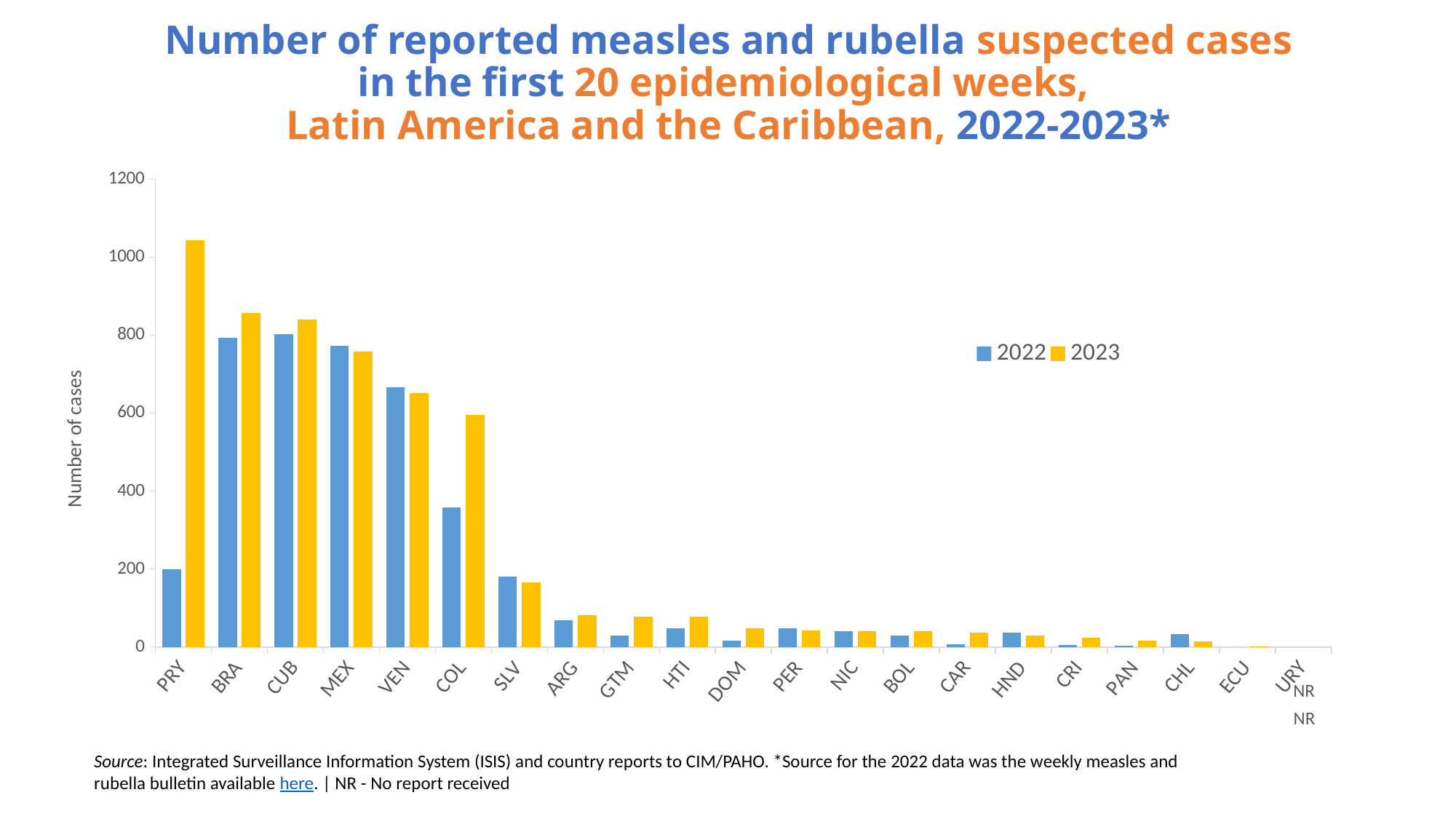
Is the 2023 value for BRA greater or less than 800? greater How many countries are shown on the x axis? 21 Which country has the highest number of suspected cases in 2023? PRY What is the label of the y axis? Number of cases For PRY, which year has the larger value, 2022 or 2023? 2023 How many series does the legend list? 2 Is the 2023 value for PRY greater or less than 1000? greater For COL, which year has the larger value, 2022 or 2023? 2023 Do the 2023 values generally rise or fall moving from left to right along the x axis? fall Is the 2022 value for PRY greater or less than 400? less What kind of chart is shown on the slide? bar chart